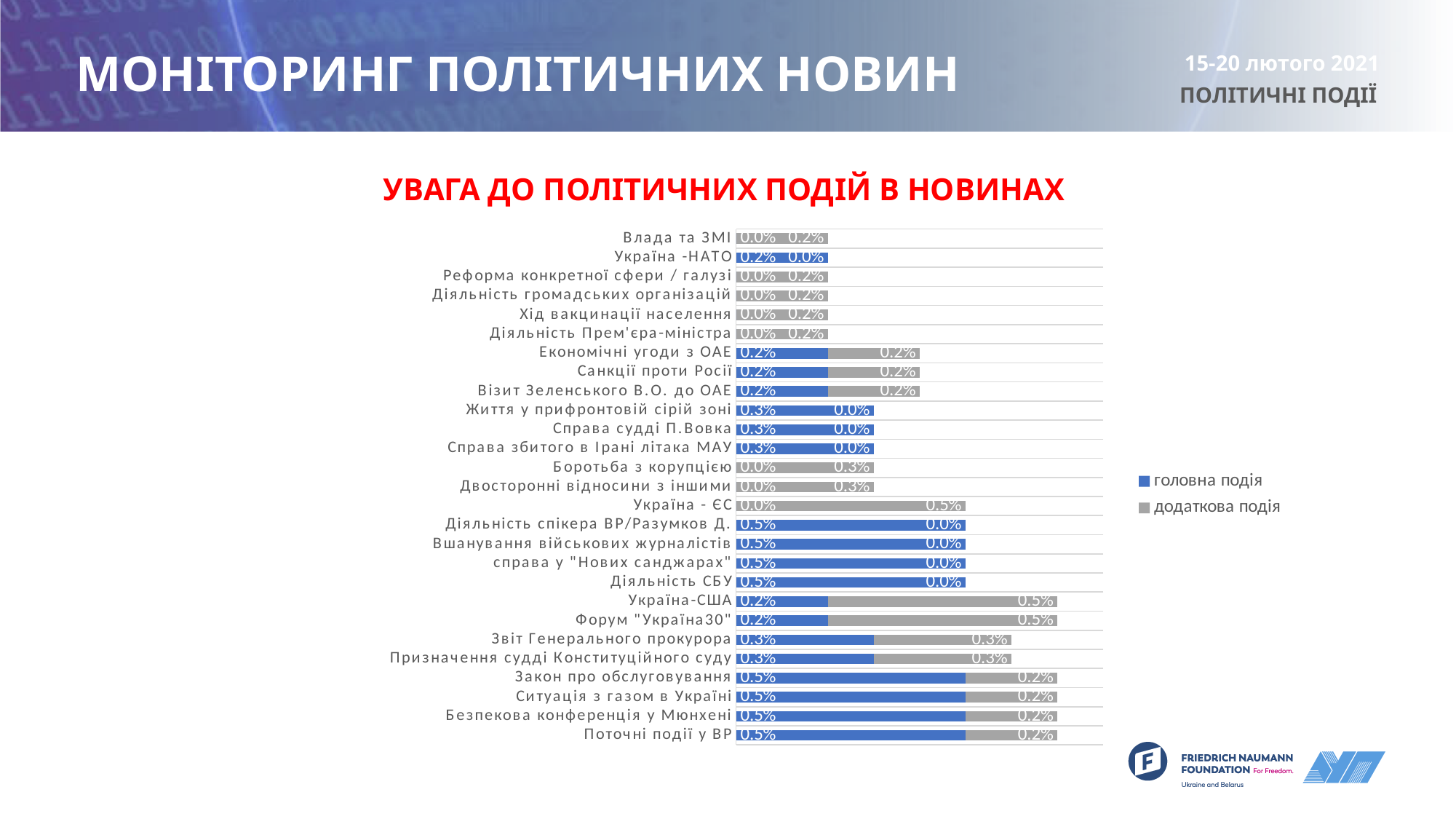
What is the total of the stacked bar for 'Форум "Україна30"'? 0.7% What is the value of 'додаткова подія' for 'Україна - ЄС'? 0.5% What is the total of the stacked bar for 'Безпекова конференція у Мюнхені'? 0.7% What is the value of 'головна подія' for 'Поточні події у ВР'? 0.5% Which is larger for 'Україна-США': the 'головна подія' value or the 'додаткова подія' value? додаткова подія How many series does the legend list? 2 What is the value of 'головна подія' for 'Звіт Генерального прокурора'? 0.3% What is the difference between the 'додаткова подія' value for 'Україна-США' and the 'додаткова подія' value for 'Закон про обслуговування'? 0.3% What is the value of 'додаткова подія' for 'Україна-США'? 0.5% What kind of chart is shown on the slide? Stacked bar chart How many categories (topics) are plotted on the chart? 27 What are the two series named in the legend? головна подія and додаткова подія